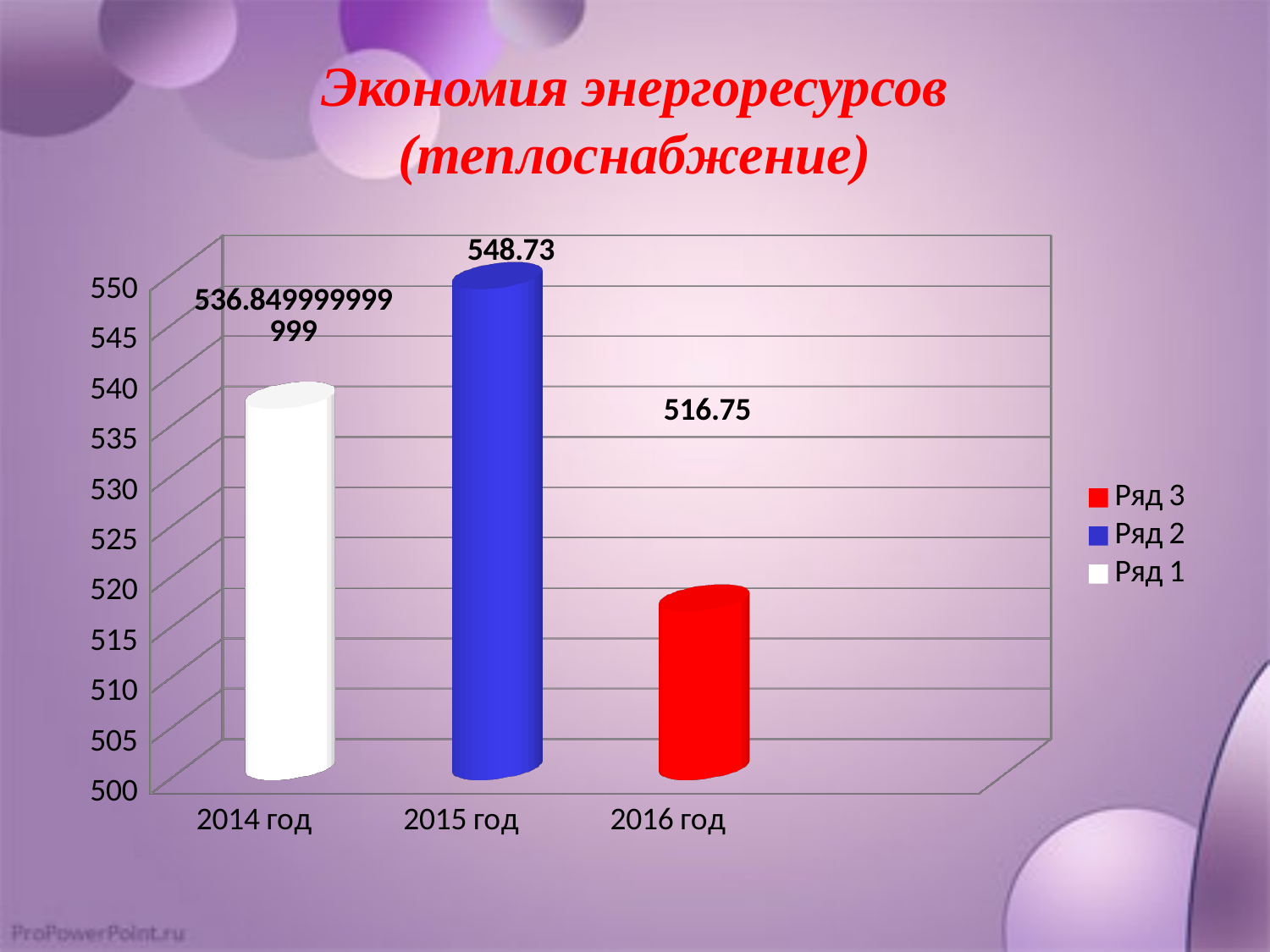
Which year has the highest value? 2015 год What value is shown for 2016 год? 516.75 How many years are shown on the x axis? 3 Which year has the lowest value? 2016 год What value is shown for 2015 год? 548.73 Which is larger, the value for 2014 год or the value for 2016 год? 2014 год How many series does the legend list? 3 What value is shown for 2014 год? 536.849999999999 Is the value for 2016 год greater or less than 520? less Does the value rise or fall from 2015 год to 2016 год? fall What kind of chart is shown on the slide? bar chart What is the difference between the values for 2015 год and 2016 год? 31.98